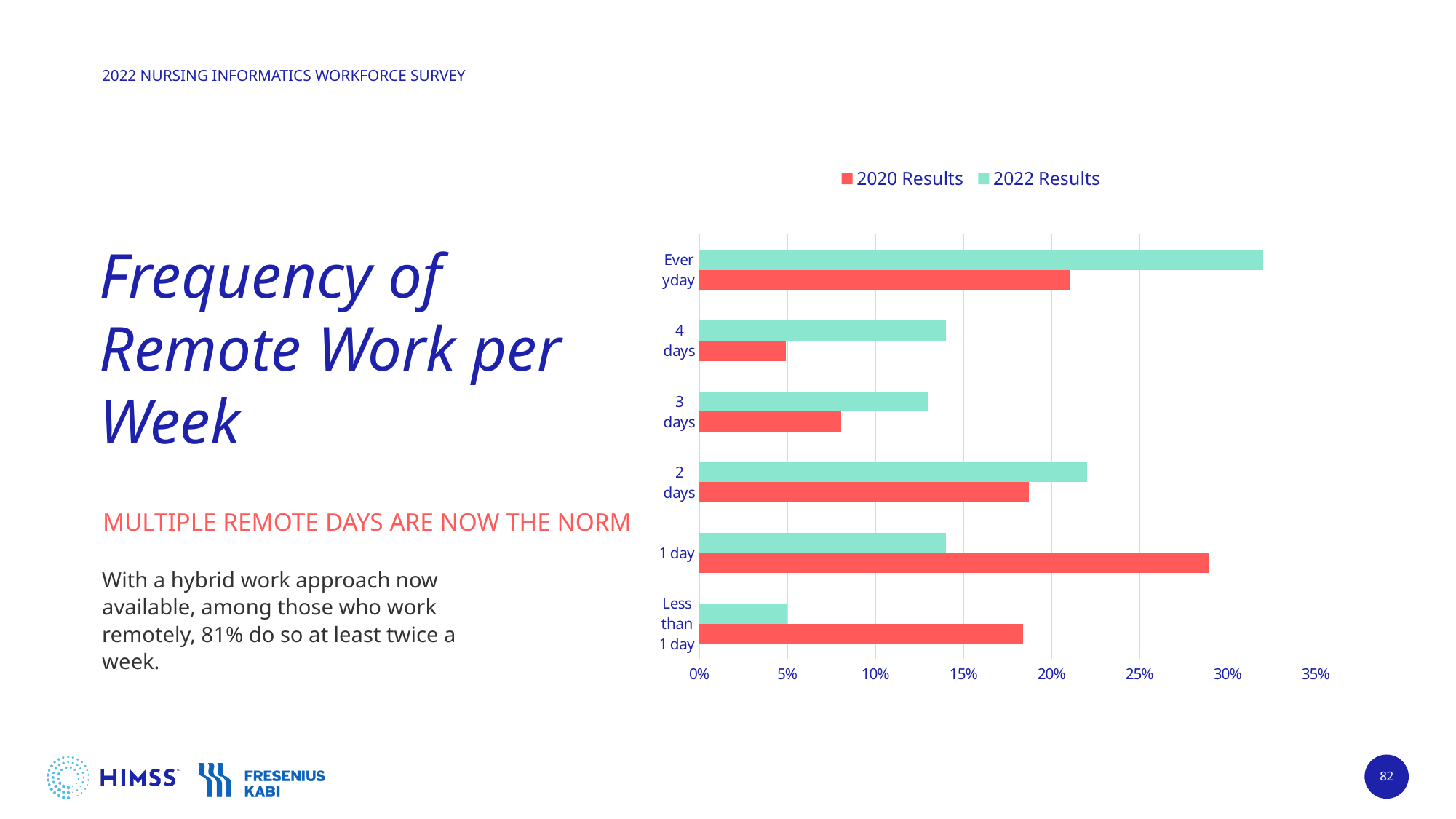
Is the 2022 Results value for Everyday greater or less than 30%? greater Which category has the highest value for 2022 Results? Everyday How many categories of remote work frequency are shown on the chart? 6 Which series is shown in red on the chart? 2020 Results How many series does the chart legend list? 2 Which category has the lowest value for 2020 Results? 4 days What kind of chart is shown on the slide? bar chart Is the 2020 Results value for 1 day greater or less than 25%? greater Which category has the lowest value for 2022 Results? Less than 1 day For the 1 day category, which series has the larger value, 2020 Results or 2022 Results? 2020 Results Which category has the highest value for 2020 Results? 1 day Is the 2020 Results value for 3 days greater or less than 10%? less